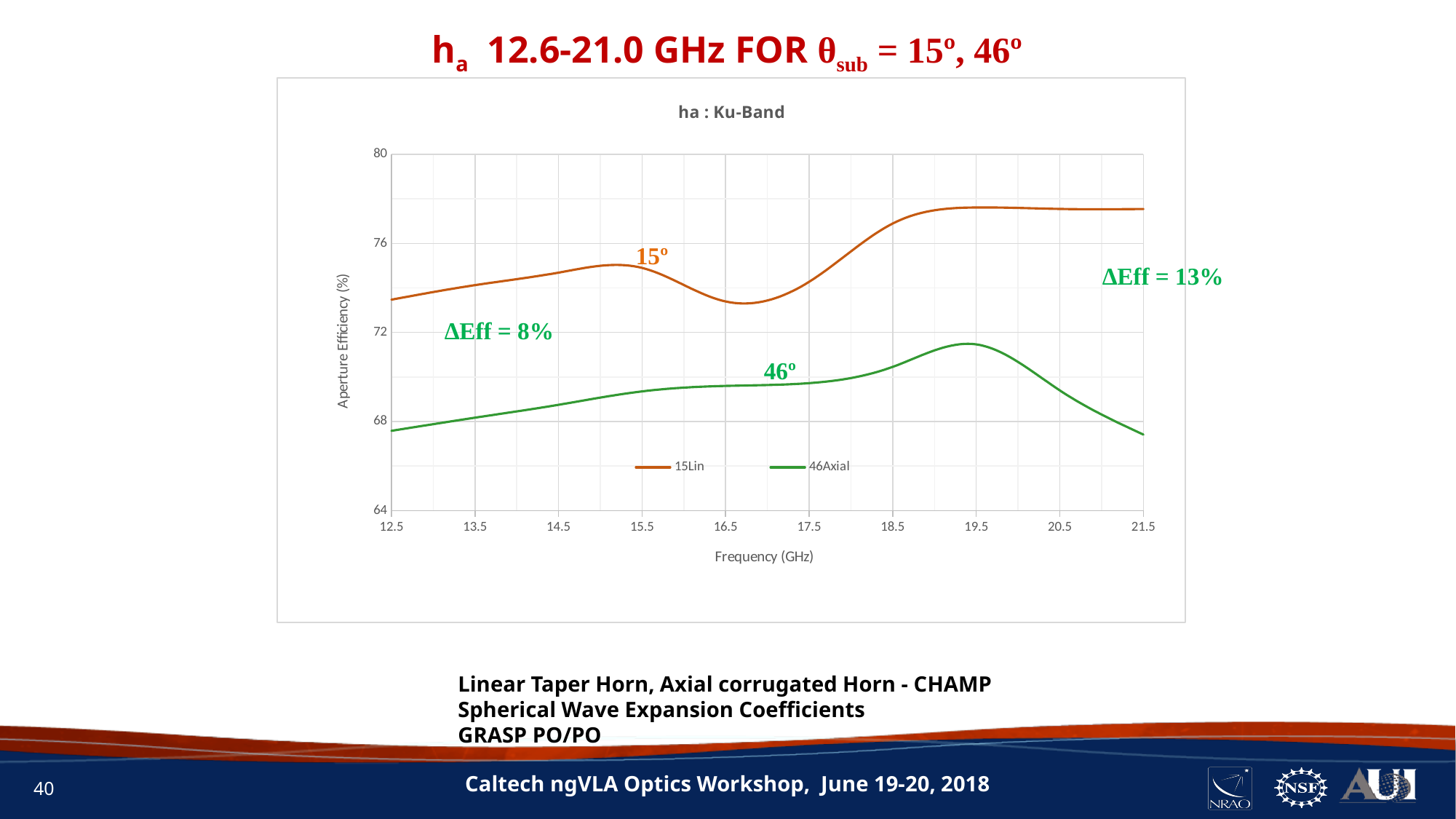
Is the value of the 15Lin series at 19.5 GHz greater or less than 76? greater At 17.5 GHz, which series has the higher aperture efficiency, 15Lin or 46Axial? 15Lin Is the value of the 46Axial series at 12.5 GHz greater or less than 68? less What are the two series names listed in the chart legend? 15Lin and 46Axial Does the 46Axial series rise or fall between 19.5 GHz and 21.5 GHz? fall Is the value of the 46Axial series at 15.5 GHz greater or less than 68? greater What kind of chart is shown on the slide? line chart What ΔEff value is annotated at the right side of the chart? ΔEff = 13% How many series does the legend of the chart list? 2 Does the 15Lin series rise or fall between 12.5 GHz and 15.0 GHz? rise